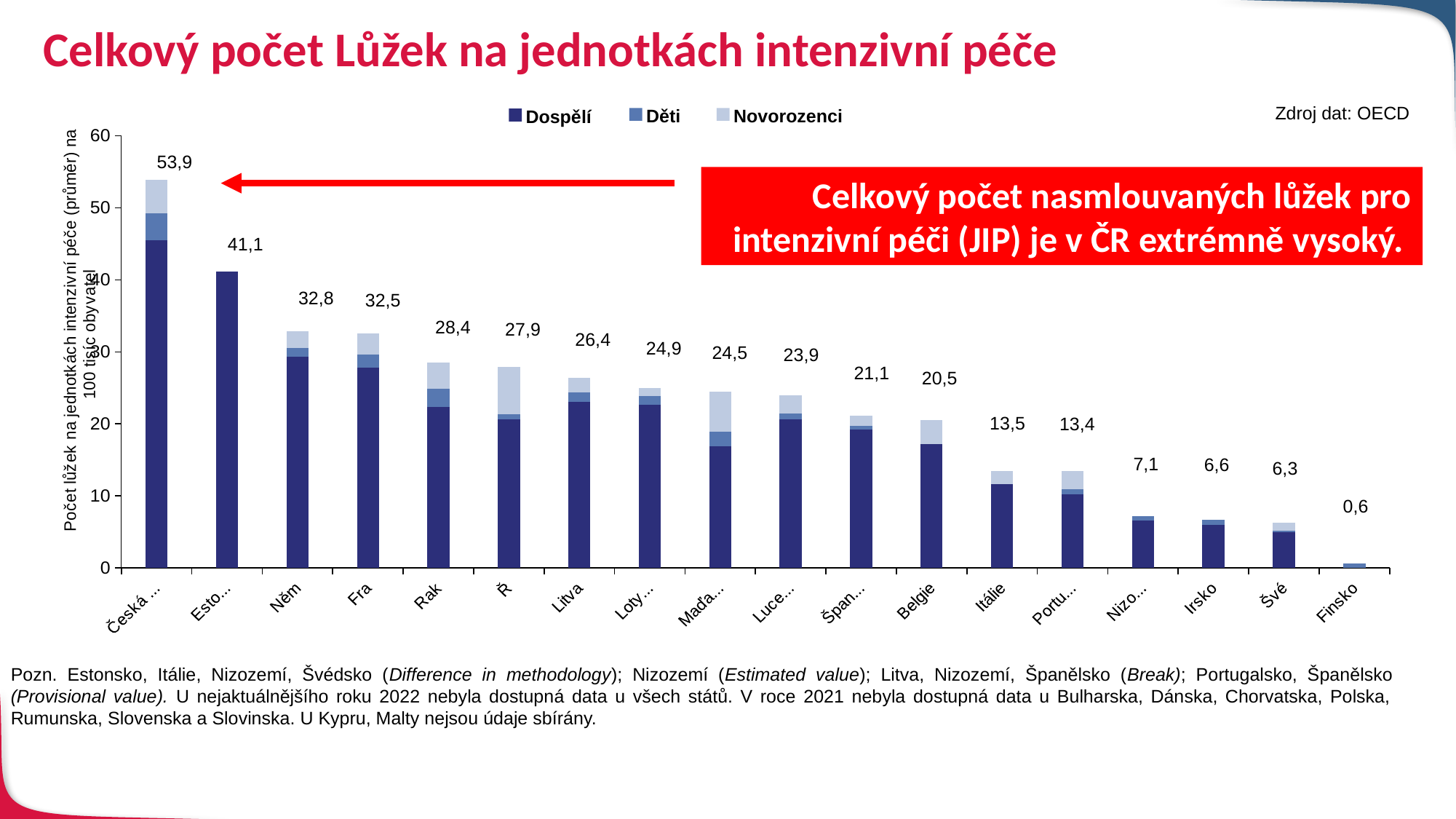
What is the total value labelled for Belgie? 20,5 What is the total value labelled for Litva? 26,4 Is the Dospělí (adults) segment for Belgie greater or less than 20? less Which country has the lowest total number of intensive care beds? Finsko Which has the larger total, Fra or Rak? Fra What is the difference between the totals for Belgie and Itálie? 7,0 Do the total values rise or fall from left to right along the x axis? fall What is the total value labelled for Itálie? 13,5 How many countries (bars) are plotted on the chart? 18 What data source is cited on the slide? OECD What kind of chart is shown on the slide? bar chart How many series does the legend list? 3